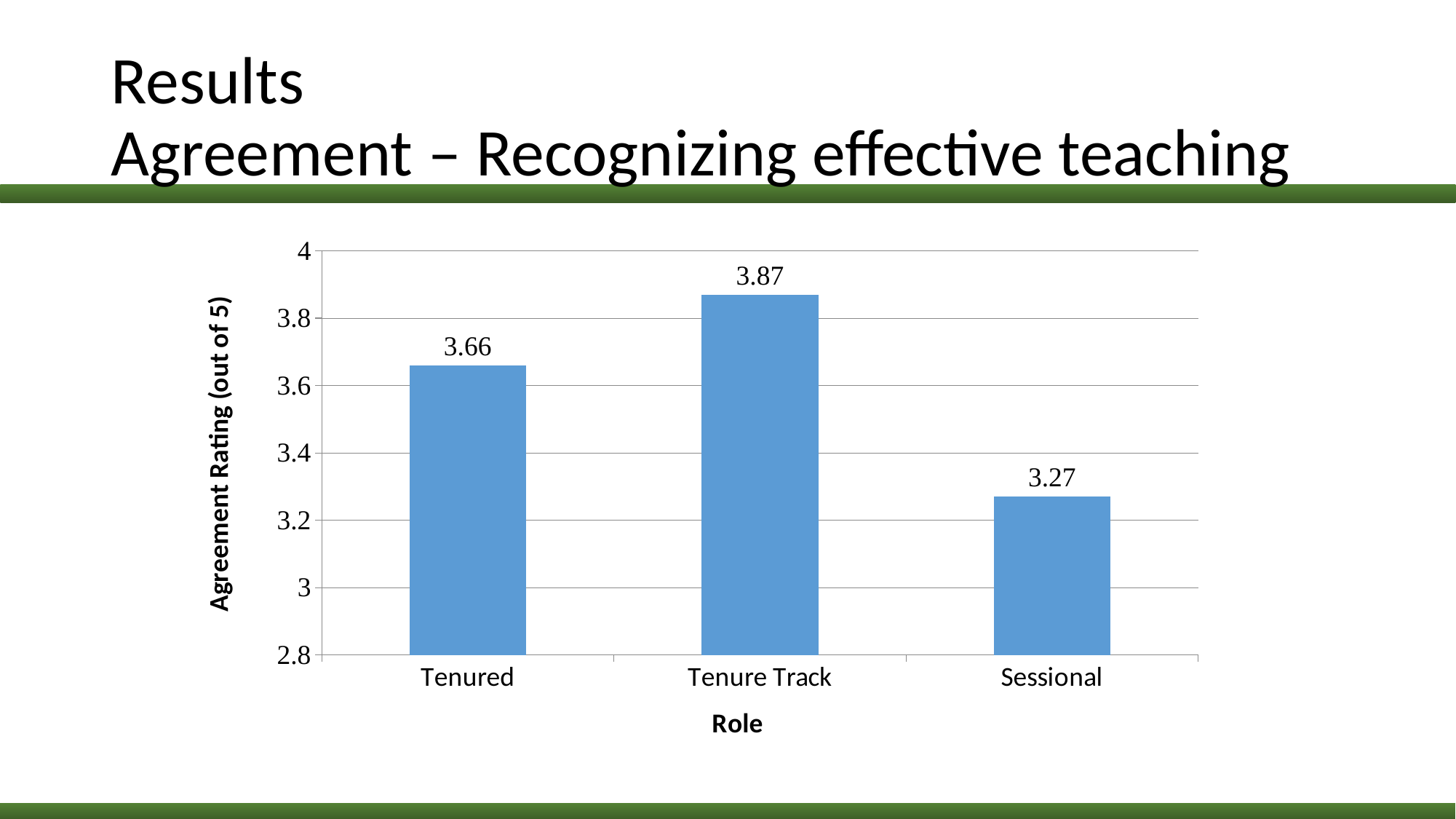
Which role has the highest agreement rating? Tenure Track Which has a higher agreement rating, Tenured or Sessional? Tenured What is the difference between the agreement ratings for Tenure Track and Sessional? 0.6 What is the difference between the agreement ratings for Tenure Track and Tenured? 0.21 What is the agreement rating for Tenured? 3.66 What is the agreement rating for Tenure Track? 3.87 Is the value for Sessional greater or less than 3.4? less What is the agreement rating for Sessional? 3.27 What is the label of the y axis? Agreement Rating (out of 5) Which role has the lowest agreement rating? Sessional What kind of chart is shown on the slide? bar chart How many roles are shown on the x axis? 3